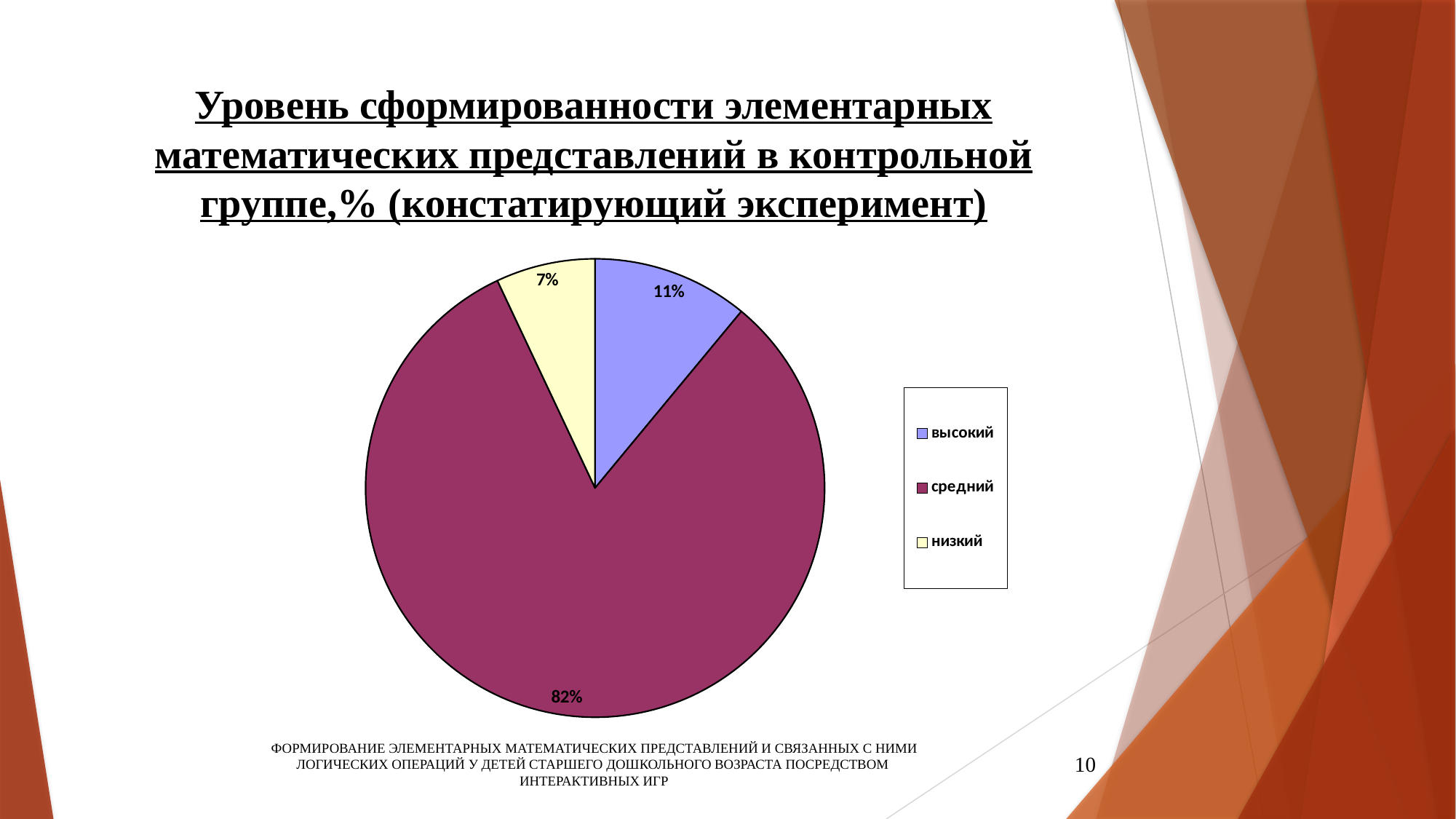
Which level has the smallest share of the pie? низкий What is the difference in percentage points between the 'средний' and 'высокий' slices? 71 What percentage is shown for the 'низкий' level? 7% How many entries does the legend list? 3 What type of chart is shown on the slide? pie chart What percentage is shown for the 'средний' level? 82% How many slices does the pie chart have? 3 What is the difference in percentage points between the 'высокий' and 'низкий' slices? 4 Which level has the largest share of the pie? средний What colour is the 'средний' slice in the pie chart? purple (magenta) Which slice is larger, 'высокий' or 'низкий'? высокий What percentage is shown for the 'высокий' level? 11%